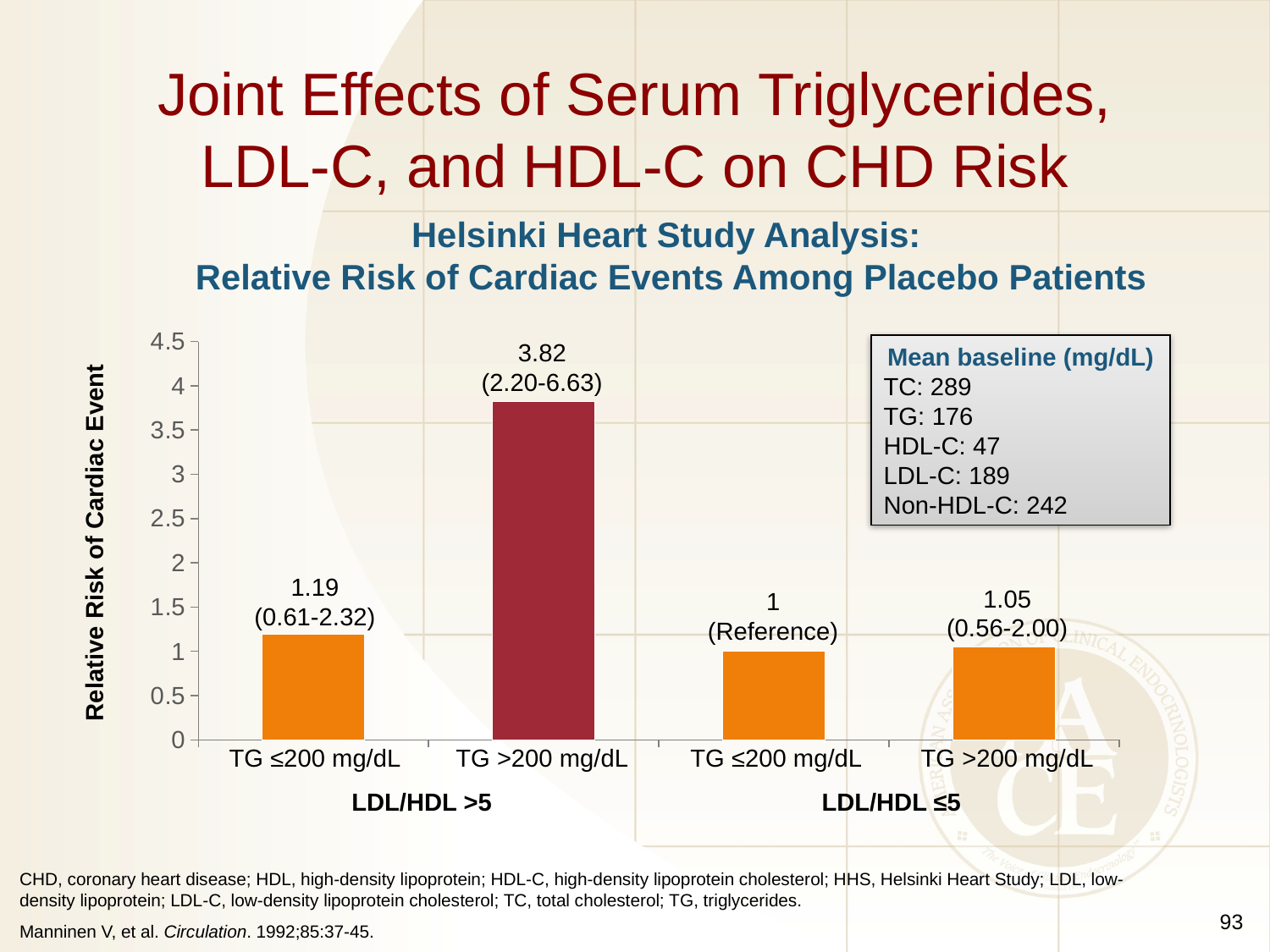
What type of chart is shown on the slide? Bar chart What is the difference in relative risk between TG >200 mg/dL and TG ≤200 mg/dL in the LDL/HDL >5 group? 2.63 Which bar has the lowest relative risk of cardiac event? TG ≤200 mg/dL, LDL/HDL ≤5 (Reference) What is the confidence interval shown for the 3.82 relative risk bar? 2.20-6.63 Which bar has the highest relative risk of cardiac event? TG >200 mg/dL, LDL/HDL >5 Which is larger: the relative risk for TG ≤200 mg/dL in the LDL/HDL >5 group or for TG >200 mg/dL in the LDL/HDL ≤5 group? TG ≤200 mg/dL in the LDL/HDL >5 group (1.19) What is the relative risk for TG >200 mg/dL in the LDL/HDL ≤5 group? 1.05 Which bar serves as the reference group with a relative risk of 1? TG ≤200 mg/dL, LDL/HDL ≤5 What is the relative risk for TG ≤200 mg/dL in the LDL/HDL >5 group? 1.19 What is the relative risk for TG >200 mg/dL in the LDL/HDL >5 group? 3.82 Is the relative risk for TG >200 mg/dL in the LDL/HDL >5 group greater or less than 3.5? greater How many bars are plotted in the chart? 4